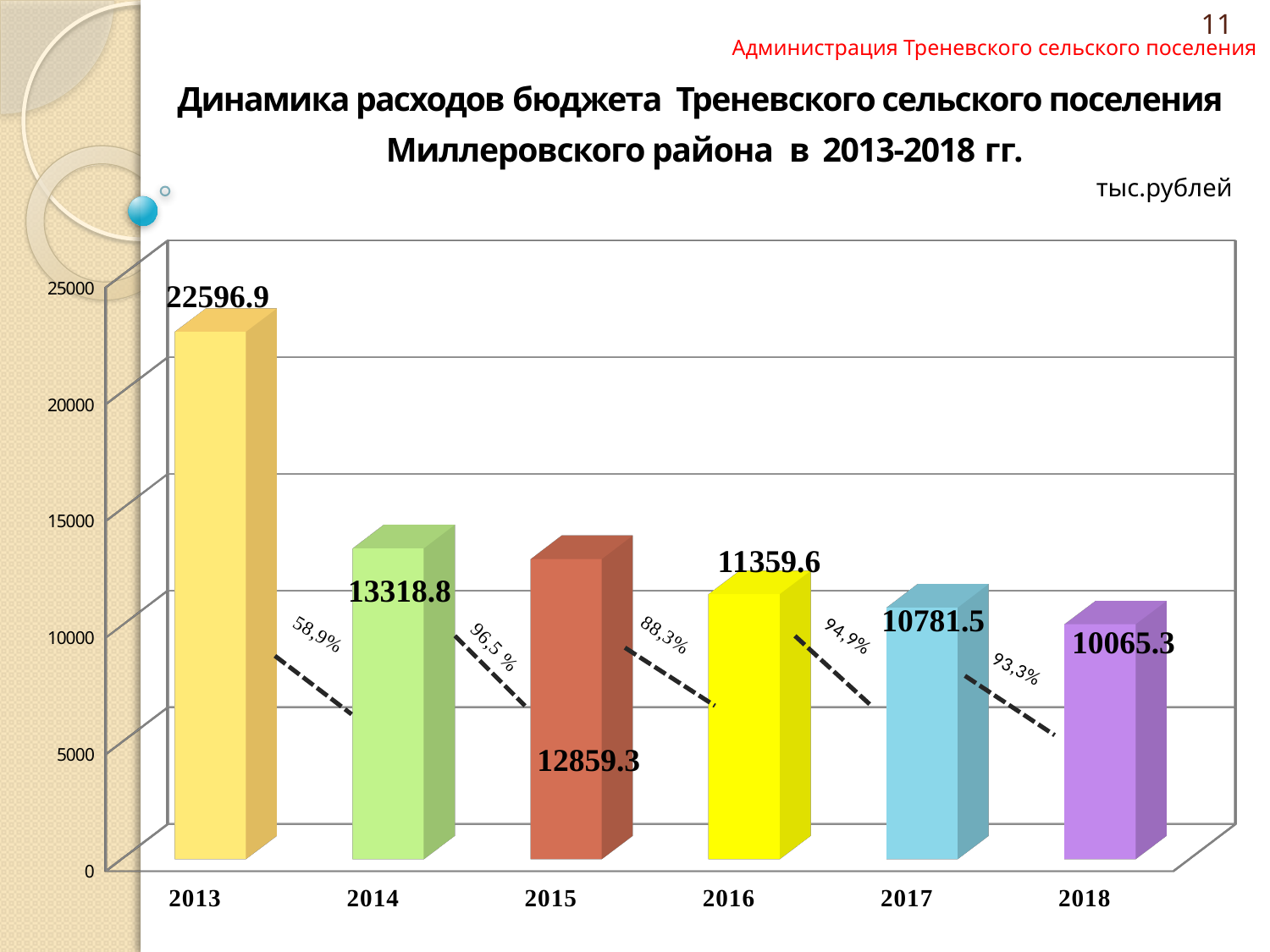
Which is larger, the value for 2014 or the value for 2015? 2014 What is the budget expenditure value for 2016? 11359.6 Which year has the lowest budget expenditure? 2018 What is the difference between the 2013 and 2014 values? 9278.1 What is the budget expenditure value for 2018? 10065.3 What is the difference between the 2017 and 2018 values? 716.2 Do the values rise or fall from 2013 to 2018? fall What kind of chart is shown on the slide? bar chart Which year has the highest budget expenditure? 2013 What is the budget expenditure value for 2013? 22596.9 Is the value for 2015 greater or less than 15000? less How many years are shown on the chart? 6